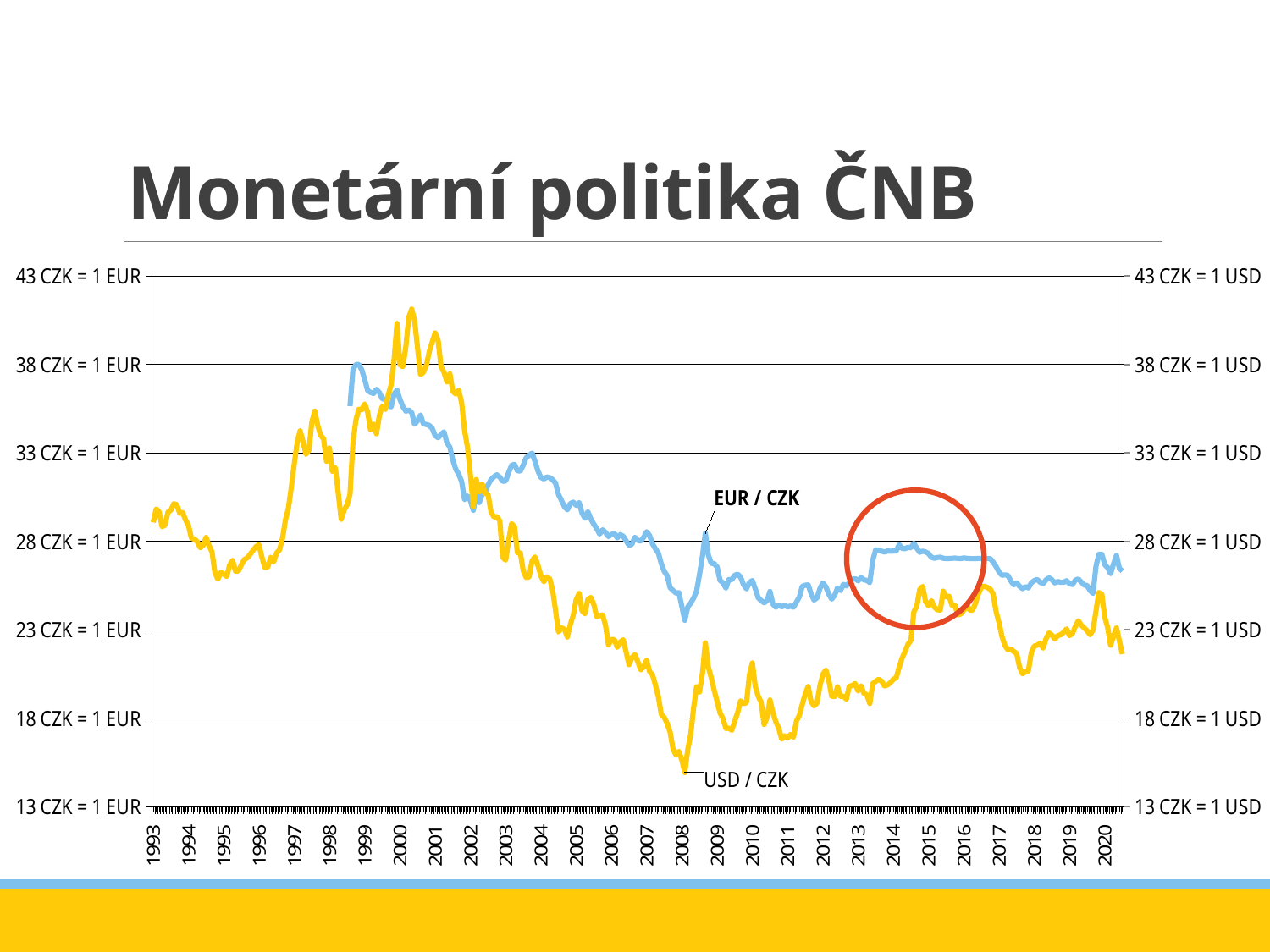
What kind of chart is shown on the slide? line chart Is the value of EUR / CZK in 2012 greater or less than 28 CZK = 1 EUR? less Is the value of EUR / CZK in 2004 greater or less than 28 CZK = 1 EUR? greater How many series (lines) are plotted on the chart? 2 Does the EUR / CZK line rise or fall between 2004 and 2008? fall How many year labels are shown on the x axis? 28 In 2010, which series has the higher value, EUR / CZK or USD / CZK? EUR / CZK What is the title of the slide above the chart? Monetární politika ČNB Which series is highlighted by the red circle on the chart? EUR / CZK Which series reaches the highest value anywhere on the chart? USD / CZK